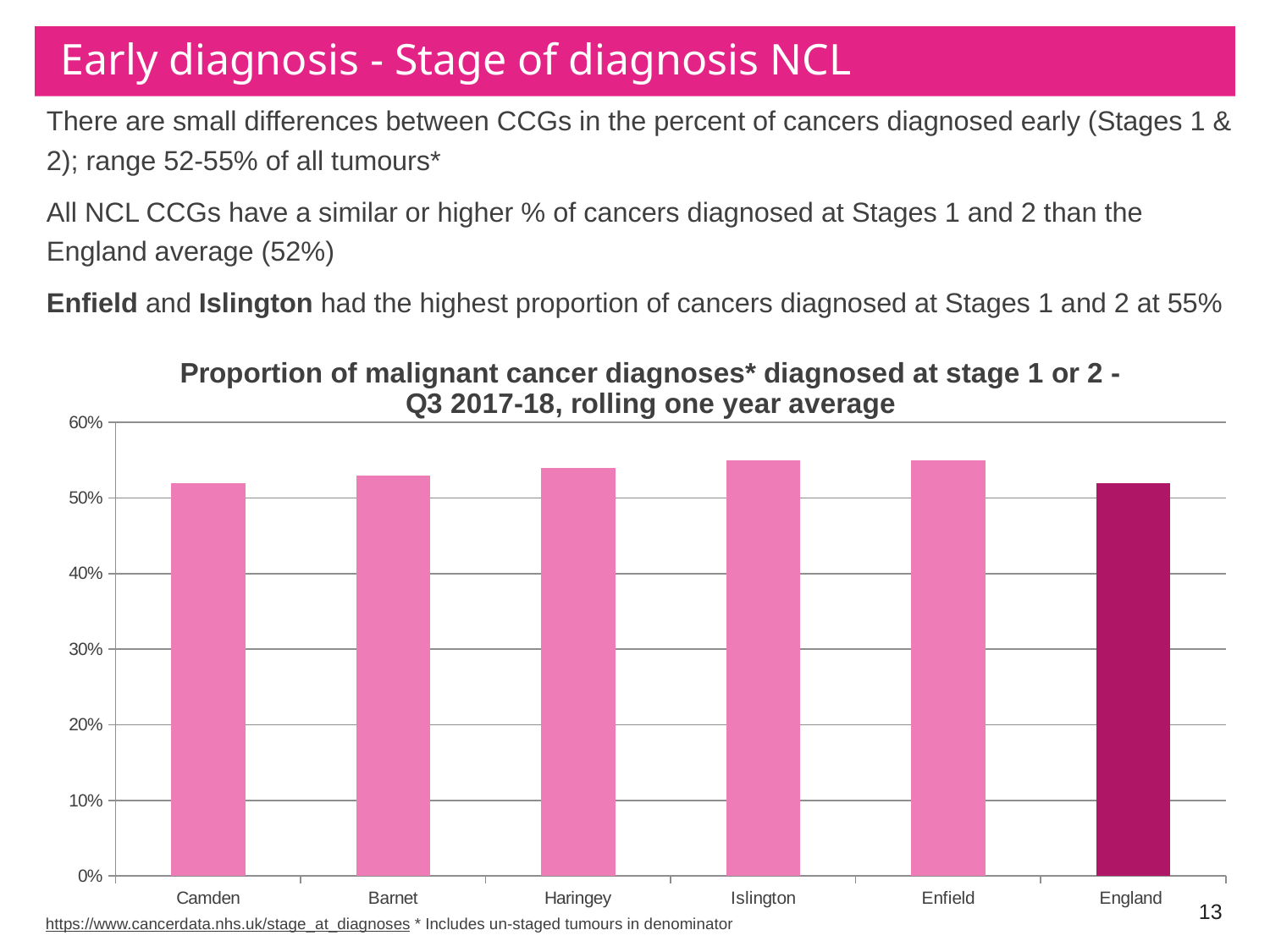
Which is larger, the value for Islington or the value for Camden? Islington What is the title of the chart? Proportion of malignant cancer diagnoses* diagnosed at stage 1 or 2 - Q3 2017-18, rolling one year average How many categories are shown on the x axis of the chart? 6 Is the value for Haringey greater or less than 50%? greater What kind of chart is shown on the slide? Bar chart According to the slide, what proportion of cancers were diagnosed at Stages 1 and 2 in Enfield? 55% Which category's bar is shown in a darker colour than the others? England Is the value for England greater or less than 60%? less Which is larger, the value for Haringey or the value for England? Haringey Is the value for Barnet greater or less than 40%? greater According to the slide, what is the England average proportion of cancers diagnosed at Stages 1 and 2? 52%